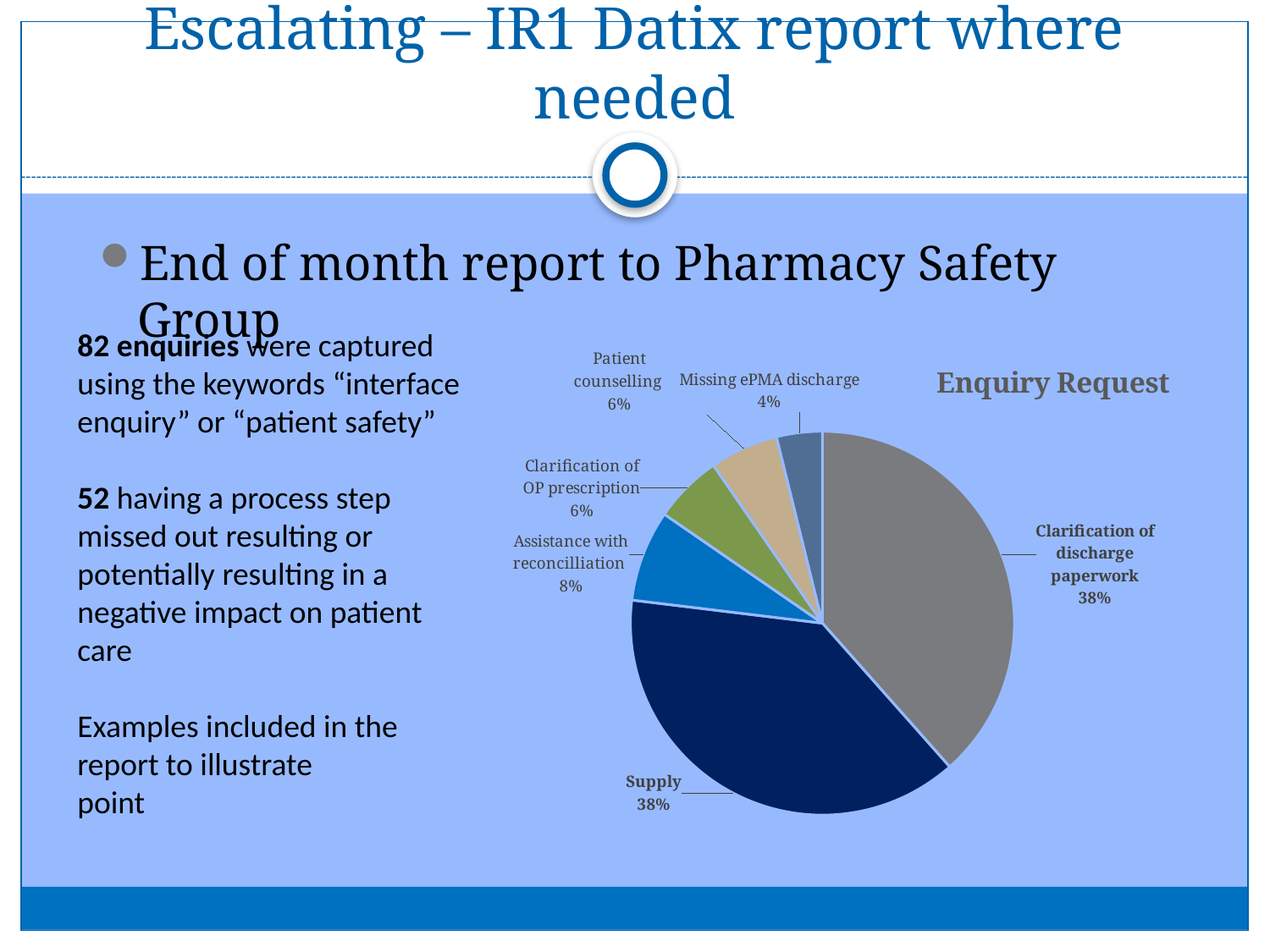
What share of the pie is Supply? 38% Which category has the smallest share of the pie? Missing ePMA discharge Which is larger, the share for Assistance with reconcilliation or the share for Patient counselling? Assistance with reconcilliation How many slices does the Enquiry Request pie chart have? 6 What is the difference in percentage points between Assistance with reconcilliation and Missing ePMA discharge? 4 What share of the pie is Clarification of discharge paperwork? 38% What percentage is shown for Assistance with reconcilliation? 8% What kind of chart is shown on the slide? pie chart What is the title of the chart? Enquiry Request What is the difference in percentage points between Supply and Assistance with reconcilliation? 30 What percentage is shown for Patient counselling? 6% What percentage is shown for Clarification of OP prescription? 6%